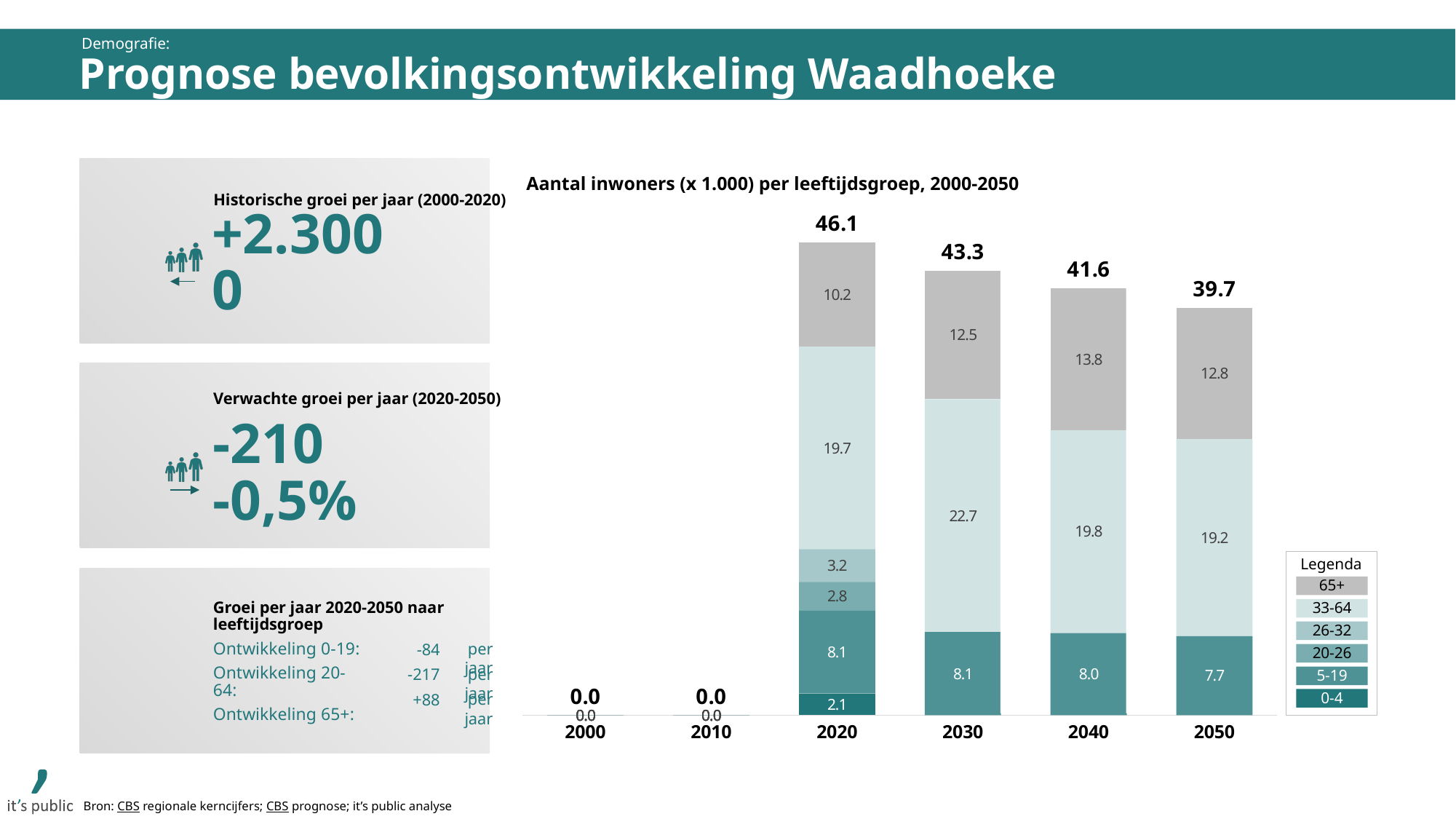
Which is larger: the 65+ value in 2030 or the 65+ value in 2050? 2050 What kind of chart is shown on the slide? Stacked bar chart What is the difference between the total for 2020 and the total for 2050? 6.4 How many years are shown on the x axis? 6 Which year has the highest total number of inhabitants? 2020 What is the value for the 0-4 age group in 2020? 2.1 What is the total number of inhabitants (x 1.000) shown for 2050? 39.7 What is the value for the 65+ age group in 2040? 13.8 How many age groups does the legend list? 6 What is the value for the 33-64 age group in 2030? 22.7 What is the total number of inhabitants (x 1.000) shown for 2020? 46.1 Do the total values rise or fall from 2020 to 2050? Fall